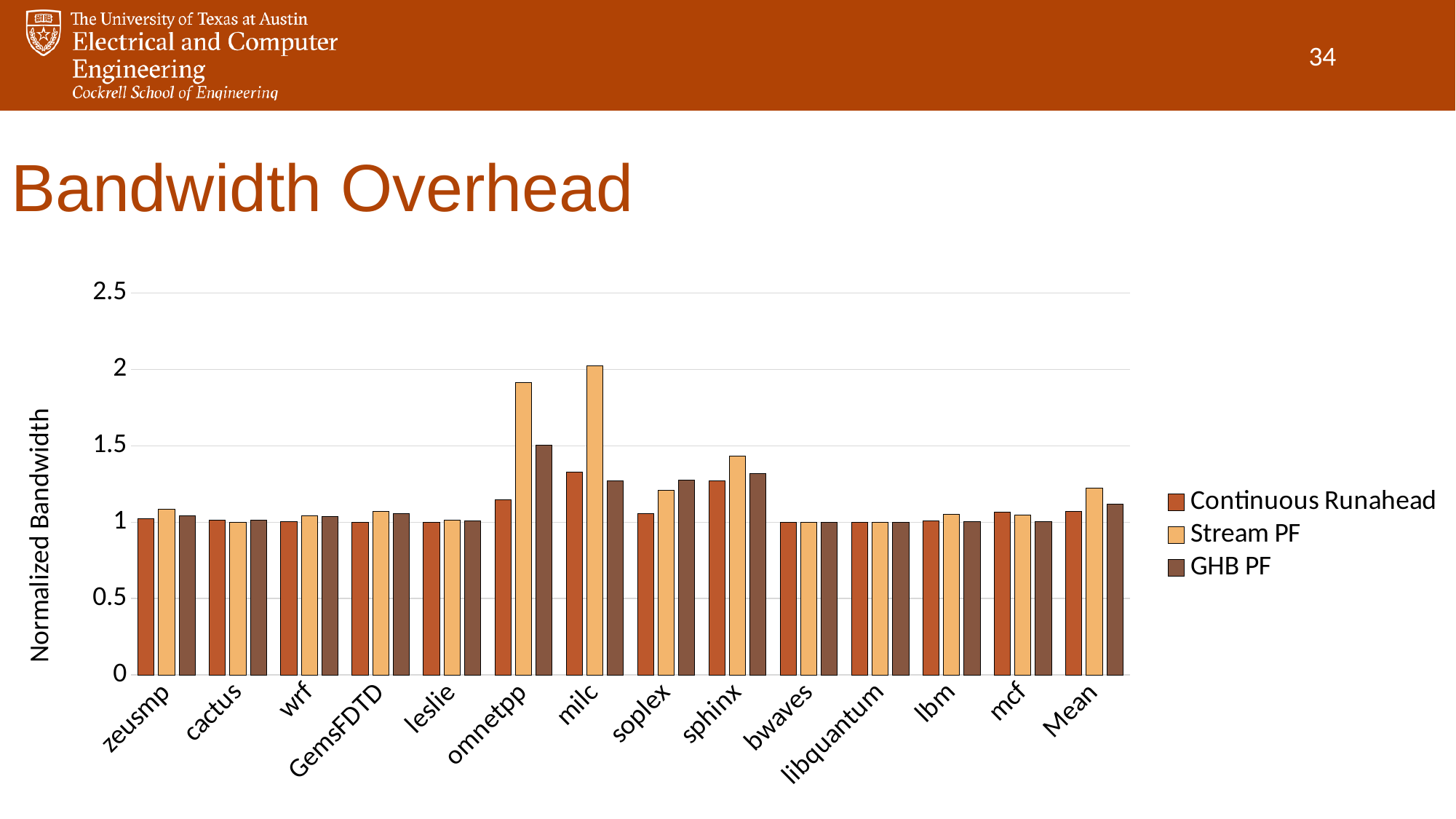
How many series does the legend list? 3 Is the Stream PF value for omnetpp greater or less than 1.5? greater Which series is shown in the lightest (tan) colour? Stream PF For which category is the GHB PF bar the highest? omnetpp Is the Continuous Runahead value for milc greater or less than 1.5? less For soplex, which is larger: the Continuous Runahead value or the GHB PF value? GHB PF How many categories are shown along the x axis? 14 Is the Stream PF value for milc greater or less than 1.5? greater What kind of chart is shown on the slide? bar chart What is the label of the y axis? Normalized Bandwidth For which category is the Stream PF bar the highest? milc For omnetpp, which is larger: the Stream PF value or the GHB PF value? Stream PF